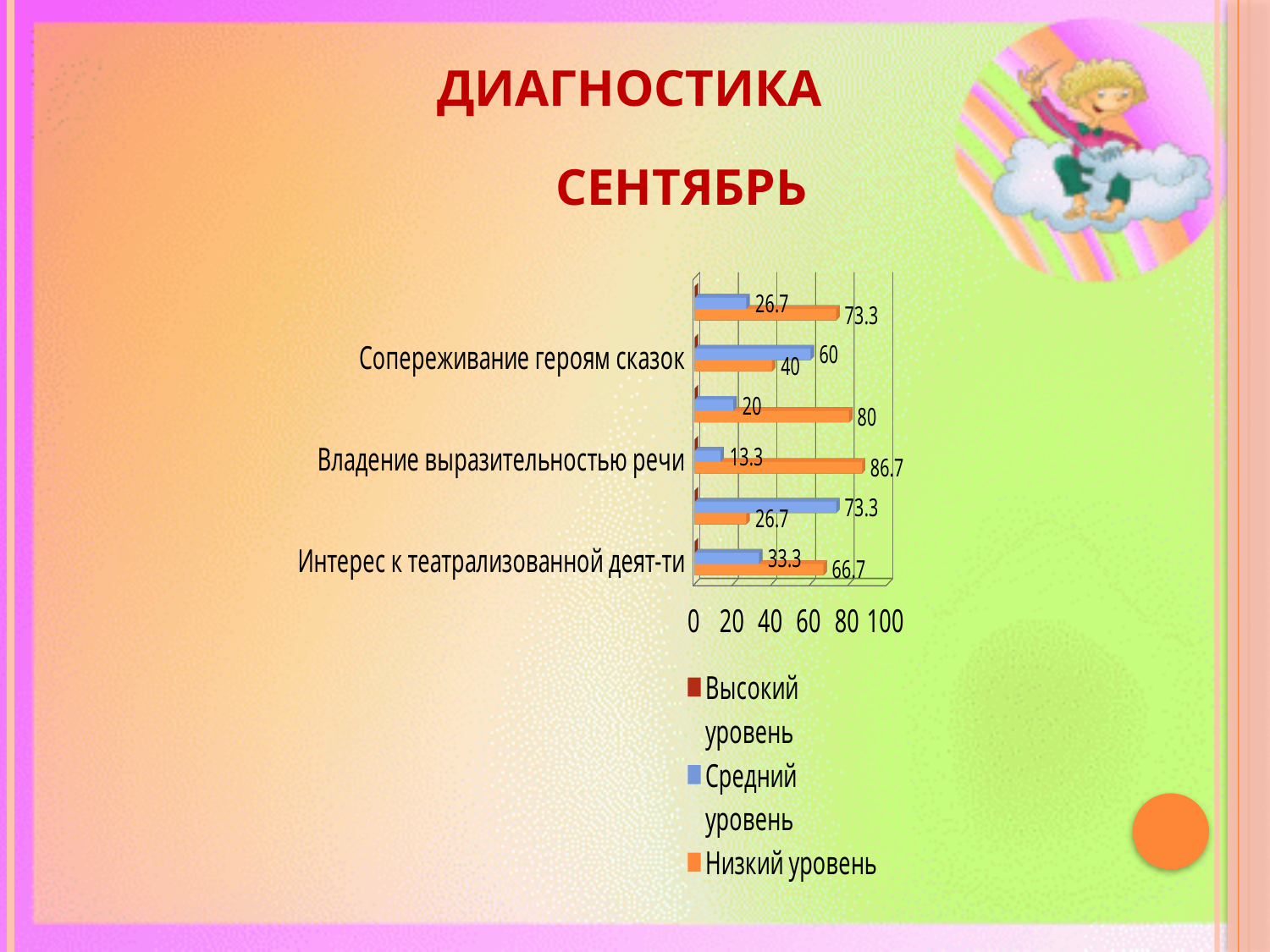
For Владение выразительностью речи, what is the difference between Низкий уровень and Средний уровень? 73.4 What are the three entries in the chart legend? Высокий уровень, Средний уровень, Низкий уровень What is the value of Средний уровень for Сопереживание героям сказок? 60 What is the value of Низкий уровень for Сопереживание героям сказок? 40 For Сопереживание героям сказок, which is larger: Средний уровень or Низкий уровень? Средний уровень What kind of chart is shown on the slide? bar chart What is the value of Средний уровень for Интерес к театрализованной деят-ти? 33.3 What is the value of Низкий уровень for Владение выразительностью речи? 86.7 Among the three labelled categories, which has the highest Низкий уровень value? Владение выразительностью речи What is the value of Средний уровень for Владение выразительностью речи? 13.3 What is the value of Низкий уровень for Интерес к театрализованной деят-ти? 66.7 How many series does the chart legend list? 3